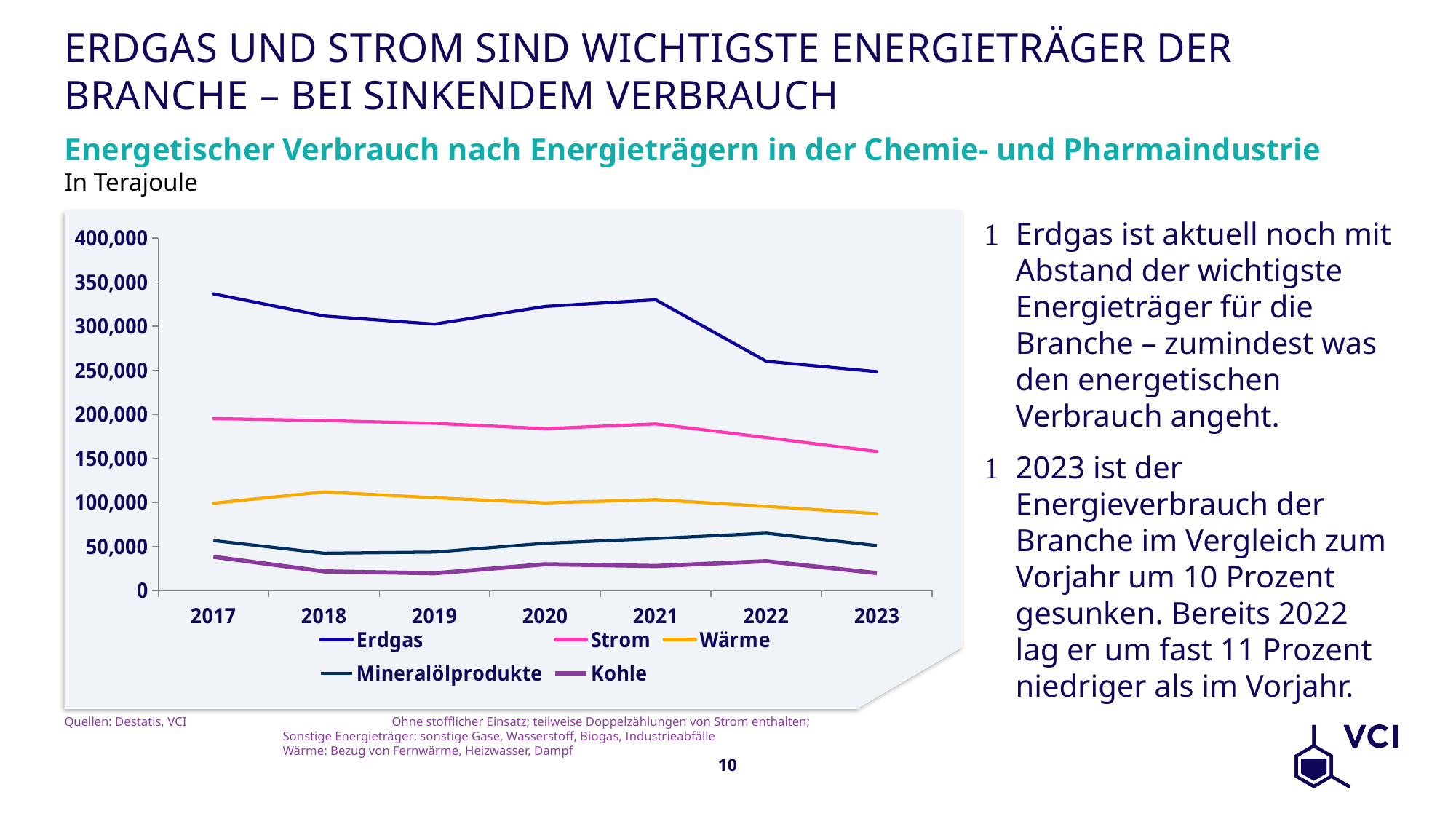
Is the value for Kohle in 2019 greater or less than 50,000? less Is the value for Erdgas in 2017 greater or less than 300,000? greater Is the value for Erdgas in 2023 greater or less than 300,000? less How many years are plotted along the x axis of the chart? 7 In what unit are the values of the chart given? Terajoule Which energy source has the highest consumption in 2023? Erdgas What kind of chart is shown on the slide? line chart In 2022, which is larger: Mineralölprodukte or Kohle? Mineralölprodukte Which energy source has the lowest consumption in 2023? Kohle Does the Erdgas line rise or fall from 2021 to 2023? fall How many series does the legend of the chart list? 5